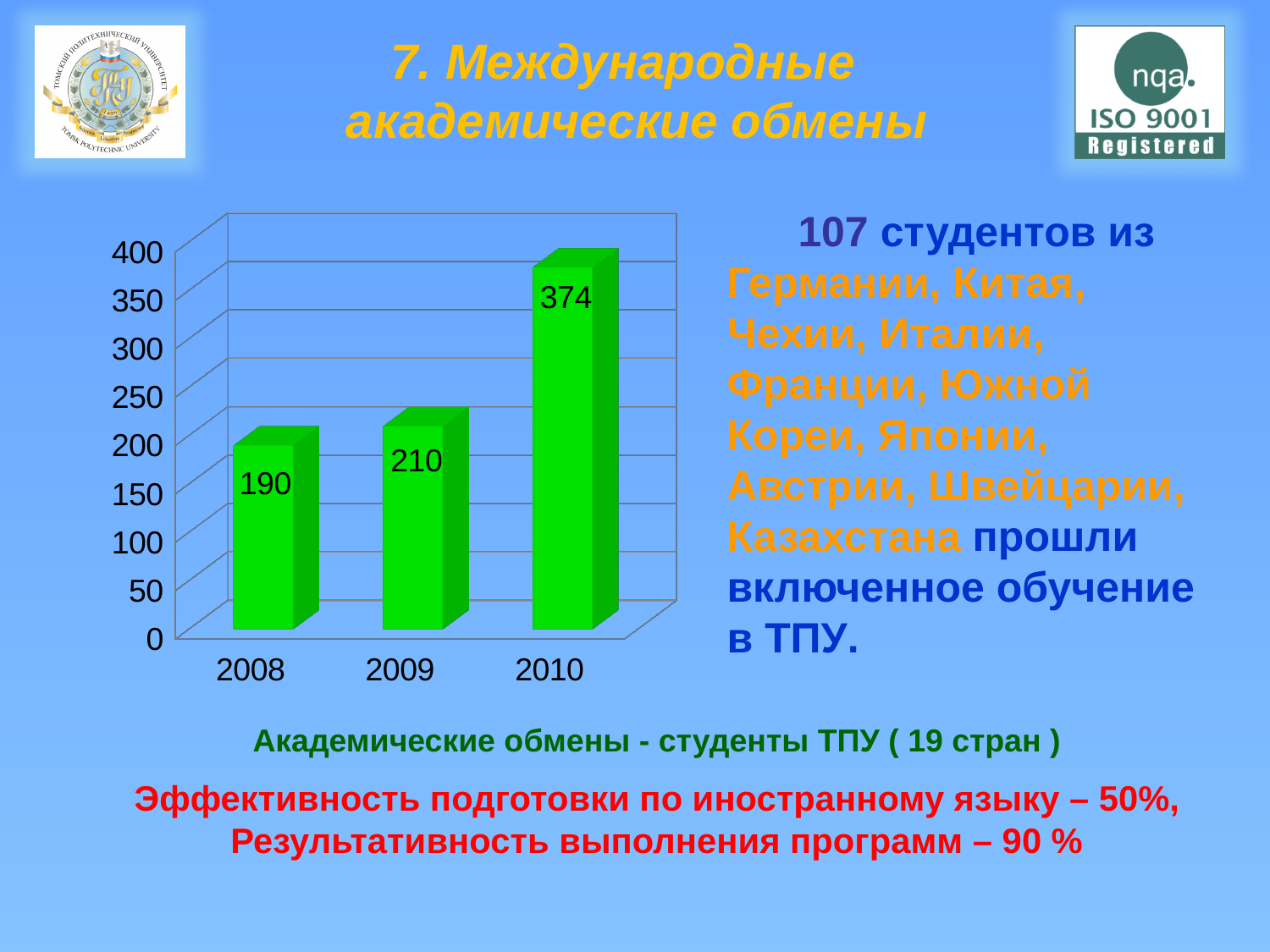
Which year has the highest value? 2010 Is the value for 2010 greater or less than 350? greater What is the value for 2010? 374 What is the difference between the values for 2009 and 2008? 20 Do the values rise or fall from 2008 to 2010? rise What is the difference between the values for 2010 and 2009? 164 Which year has the lowest value? 2008 What is the value for 2009? 210 What kind of chart is shown on the slide? bar chart Which is larger, the value for 2008 or the value for 2010? 2010 What is the value for 2008? 190 How many years are shown on the x axis? 3